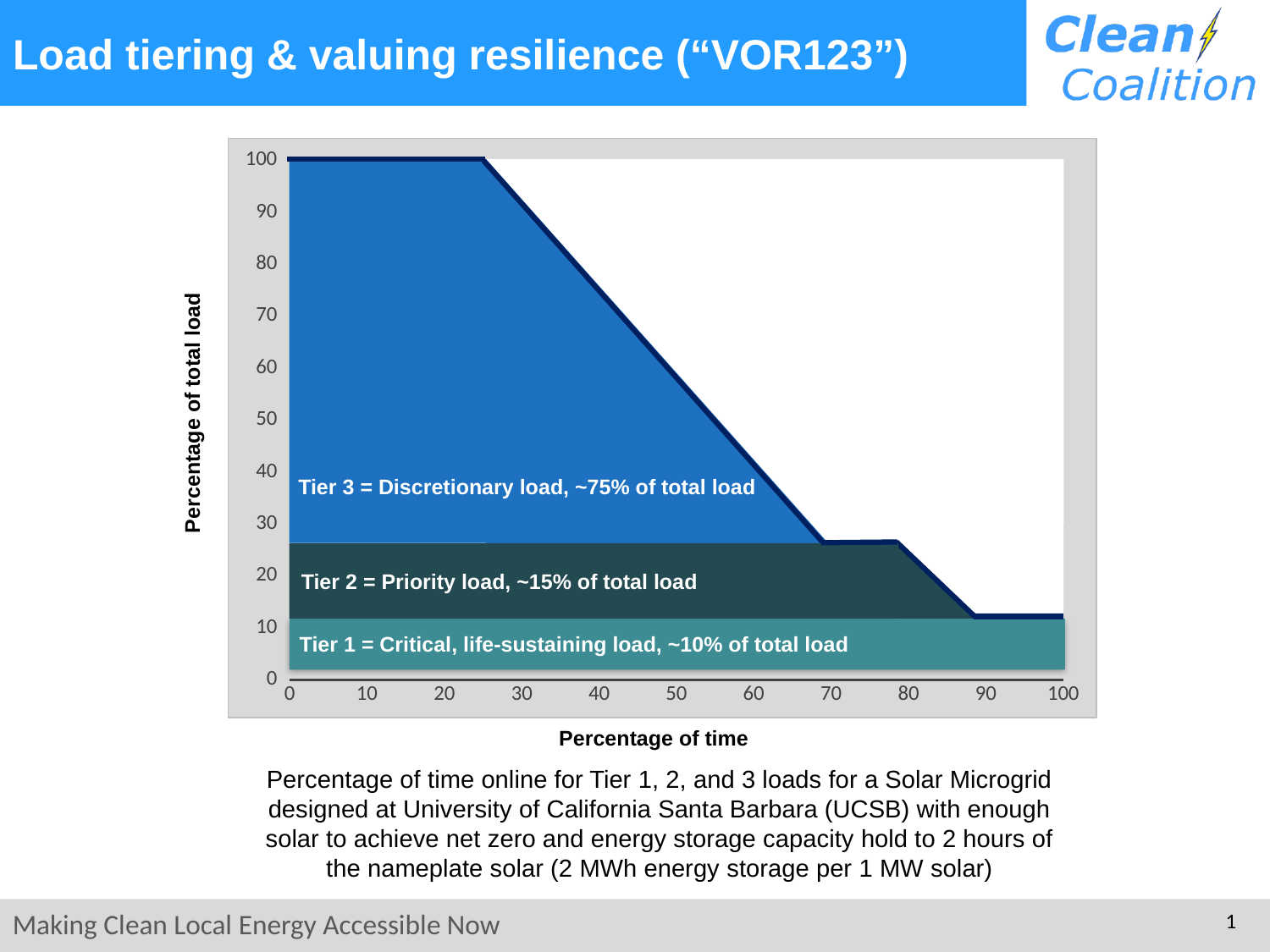
What is the title of the x axis of the chart? Percentage of time Is the percentage of total load at 50% of time greater or less than 50? greater What is the title of the y axis of the chart? Percentage of total load Is the percentage of total load at 100% of time greater or less than 20? less What is the percentage of total load at 0% of time? 100 Is the percentage of total load at 10% of time greater or less than 90? greater How many load tiers are labelled on the chart? 3 What kind of chart is shown on the slide? area chart Does the plotted line rise or fall as the percentage of time increases from 0 to 100? fall